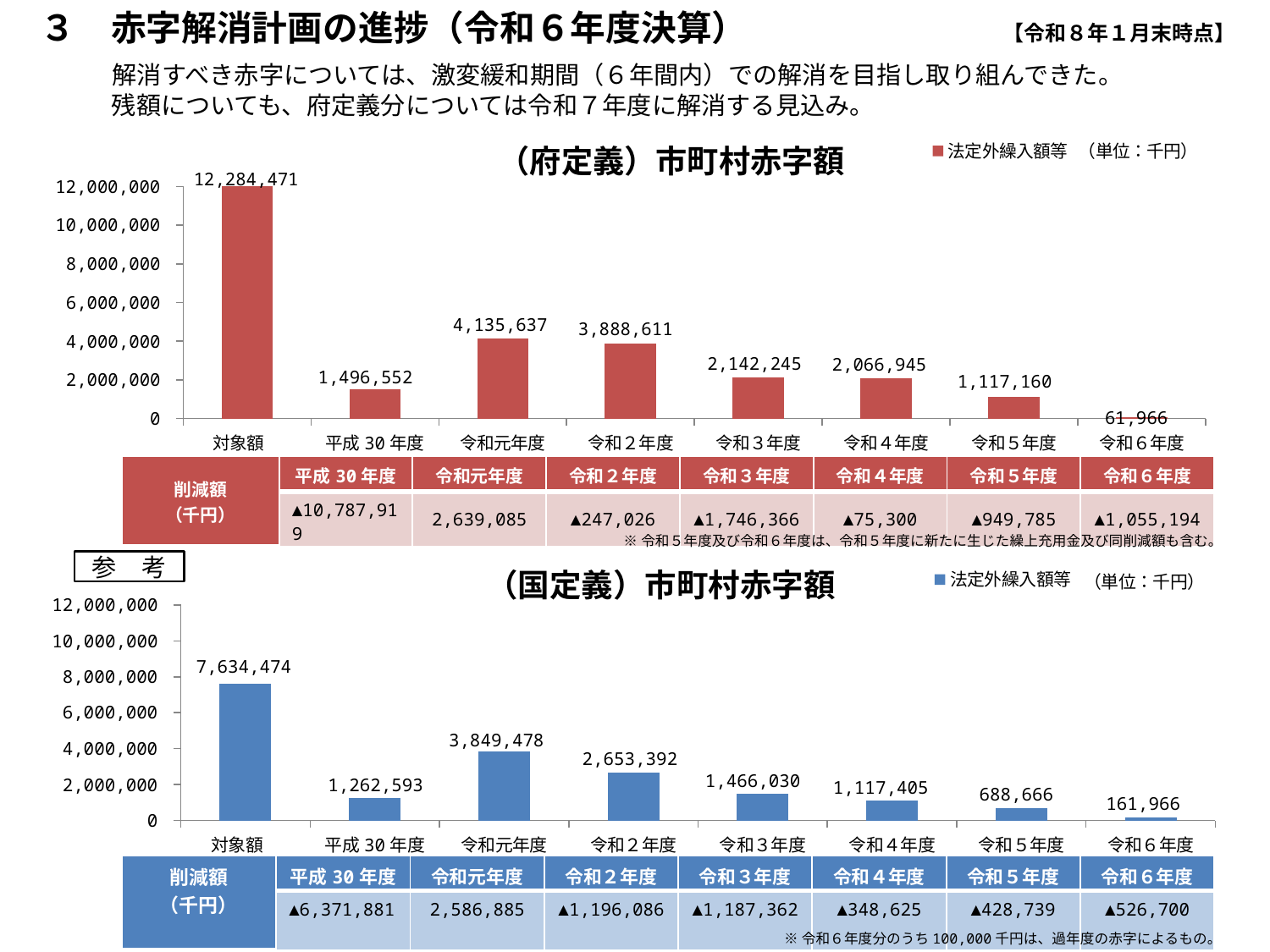
In the (府定義) 市町村赤字額 chart, which category has the lowest value? 令和６年度 In the (国定義) 市町村赤字額 chart, what is the difference between 令和２年度 and 令和３年度? 1,187,362 In the (国定義) 市町村赤字額 chart, how many series does the legend list? 1 What kind of chart is the (府定義) 市町村赤字額 chart? Bar chart In the (国定義) 市町村赤字額 chart, which category has the highest value? 対象額 In the (府定義) 市町村赤字額 chart, which is larger, 令和３年度 or 令和５年度? 令和３年度 In the (府定義) 市町村赤字額 chart, what is the value for 令和６年度? 61,966 In the (国定義) 市町村赤字額 chart, how many categories are shown on the x axis? 8 In the (国定義) 市町村赤字額 chart, what is the value for 対象額? 7,634,474 In the (府定義) 市町村赤字額 chart, what is the value for 対象額? 12,284,471 In the (国定義) 市町村赤字額 chart, what is the value for 令和５年度? 688,666 In the (府定義) 市町村赤字額 chart, what is the difference between 令和元年度 and 令和２年度? 247,026